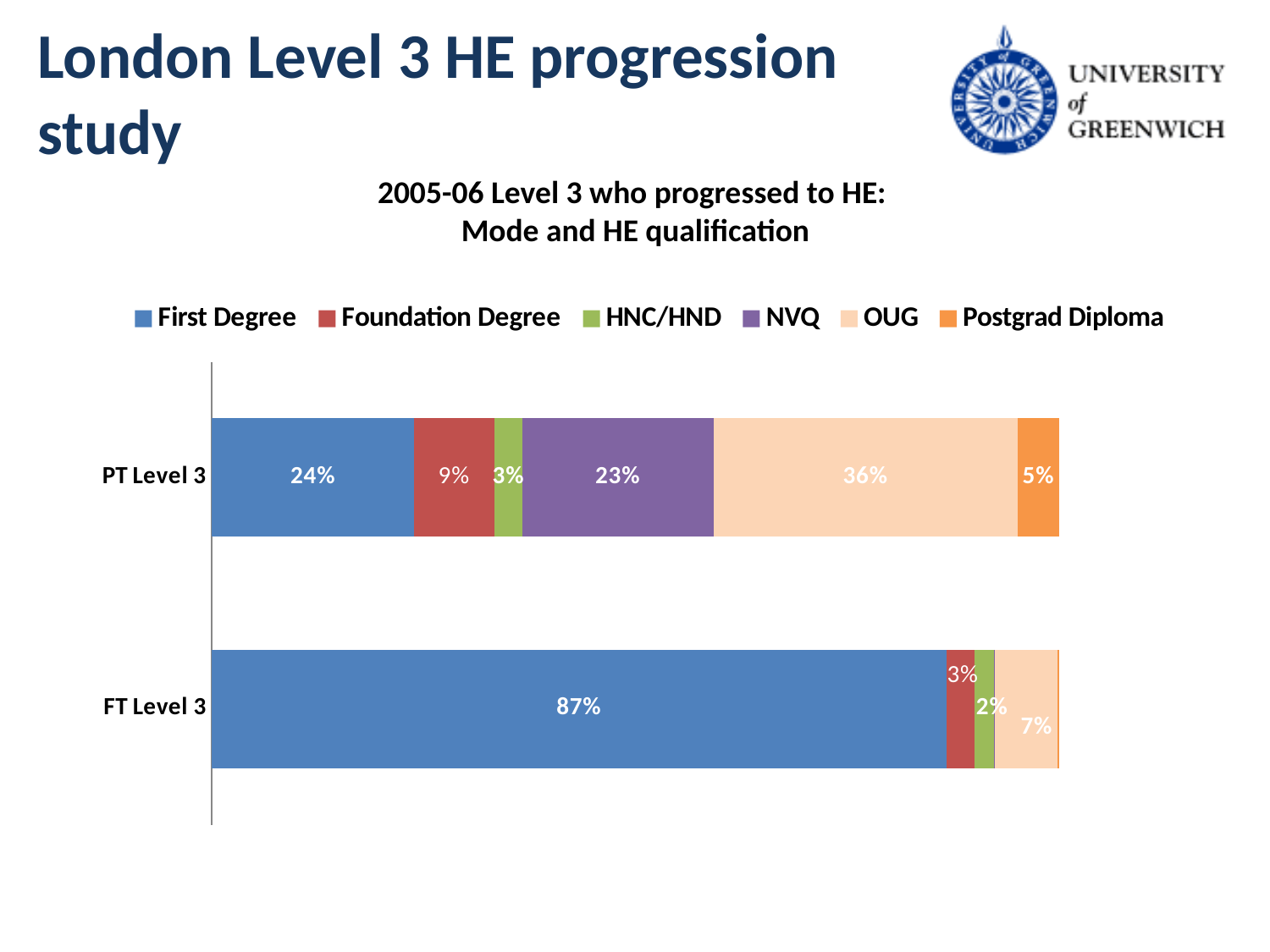
Which HE qualification has the largest share for PT Level 3? OUG Which group has the larger First Degree share, PT Level 3 or FT Level 3? FT Level 3 What percentage of FT Level 3 students progressed to a First Degree? 87% What percentage of PT Level 3 students progressed to a First Degree? 24% What is the Postgrad Diploma share for PT Level 3? 5% How many series does the legend list? 6 How many categories (bars) are shown on the chart? 2 What is the OUG share for PT Level 3? 36% What kind of chart is shown on the slide? Stacked bar chart What is the NVQ share for PT Level 3? 23% What is the OUG share for FT Level 3? 7% How much larger is the First Degree share for FT Level 3 than for PT Level 3? 63%